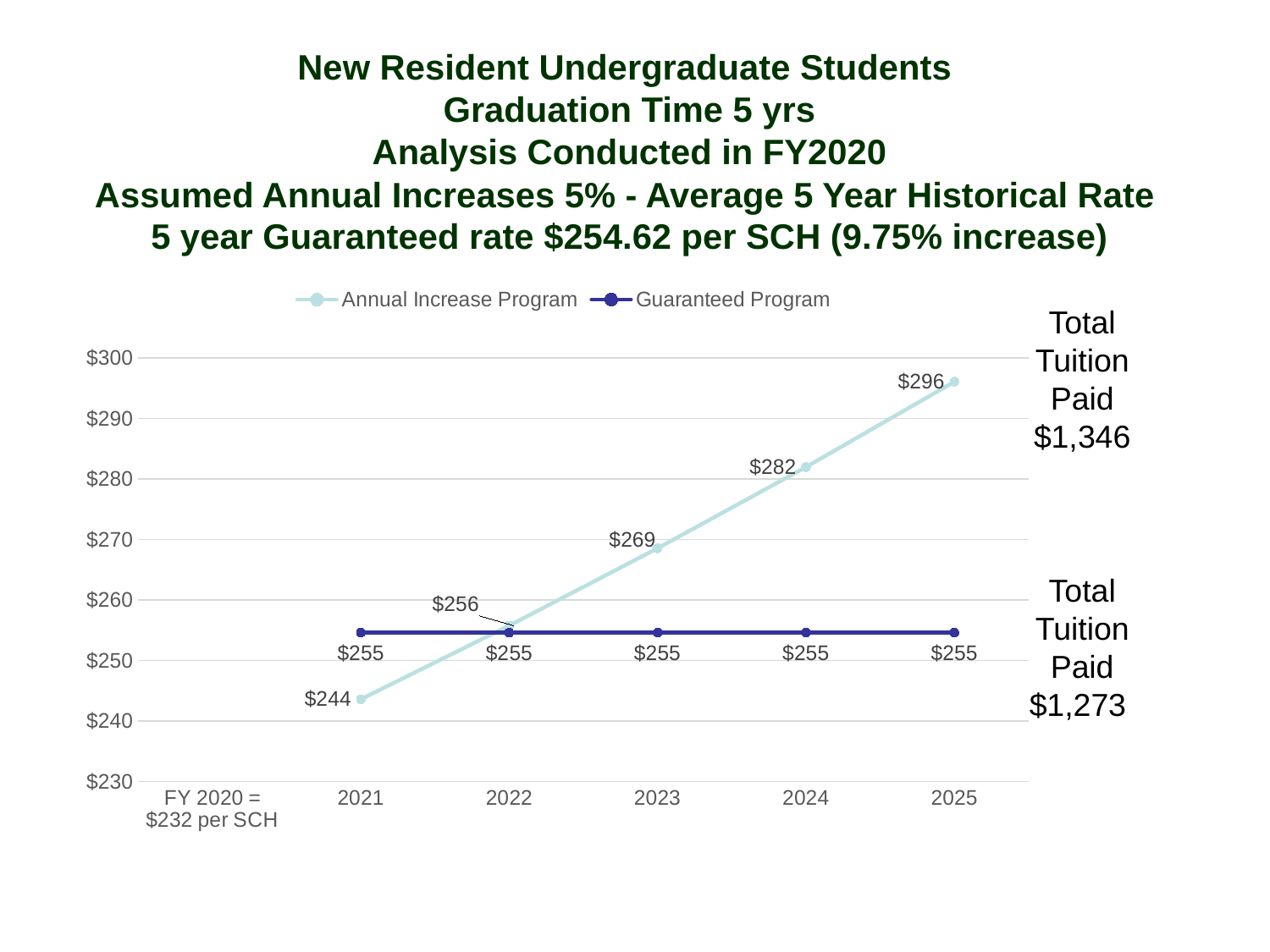
Does the Annual Increase Program line rise or fall from 2021 to 2025? Rise What is the value for the Annual Increase Program in 2023? $269 In which year is the Annual Increase Program value highest? 2025 What kind of chart is shown on the slide? Line chart Which is larger in 2021, the Annual Increase Program value or the Guaranteed Program value? Guaranteed Program What is the value for the Annual Increase Program in 2021? $244 What is the value for the Annual Increase Program in 2025? $296 Is the value for the Annual Increase Program in 2024 greater or less than $280? greater What is the difference between the Annual Increase Program and the Guaranteed Program values in 2025? $41 In which year is the Annual Increase Program value lowest? 2021 What is the value for the Guaranteed Program in 2023? $255 How many series does the legend list? 2